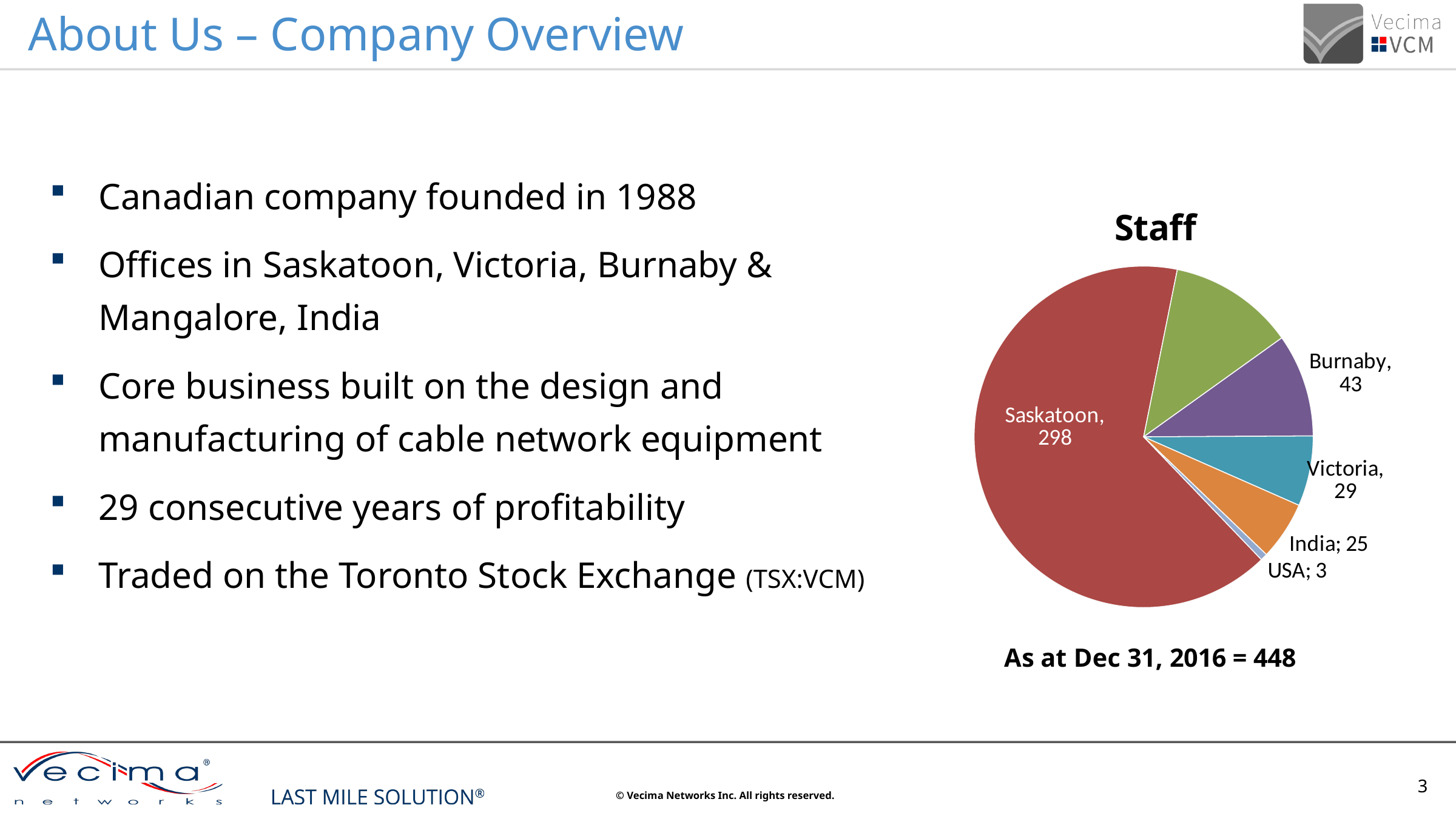
How many staff are in Saskatoon according to the chart? 298 What is the difference between the Burnaby and Victoria staff counts? 14 Which location has the largest slice of the Staff pie chart? Saskatoon What is the title of the chart? Staff What is the total staff count stated below the chart as at Dec 31, 2016? 448 How many staff are in Burnaby according to the chart? 43 Which location has the smallest slice of the Staff pie chart? USA What type of chart is shown on the slide? pie chart How many staff are in Victoria according to the chart? 29 How many staff are in India according to the chart? 25 Which has more staff, Victoria or India? Victoria How many staff are in the USA according to the chart? 3